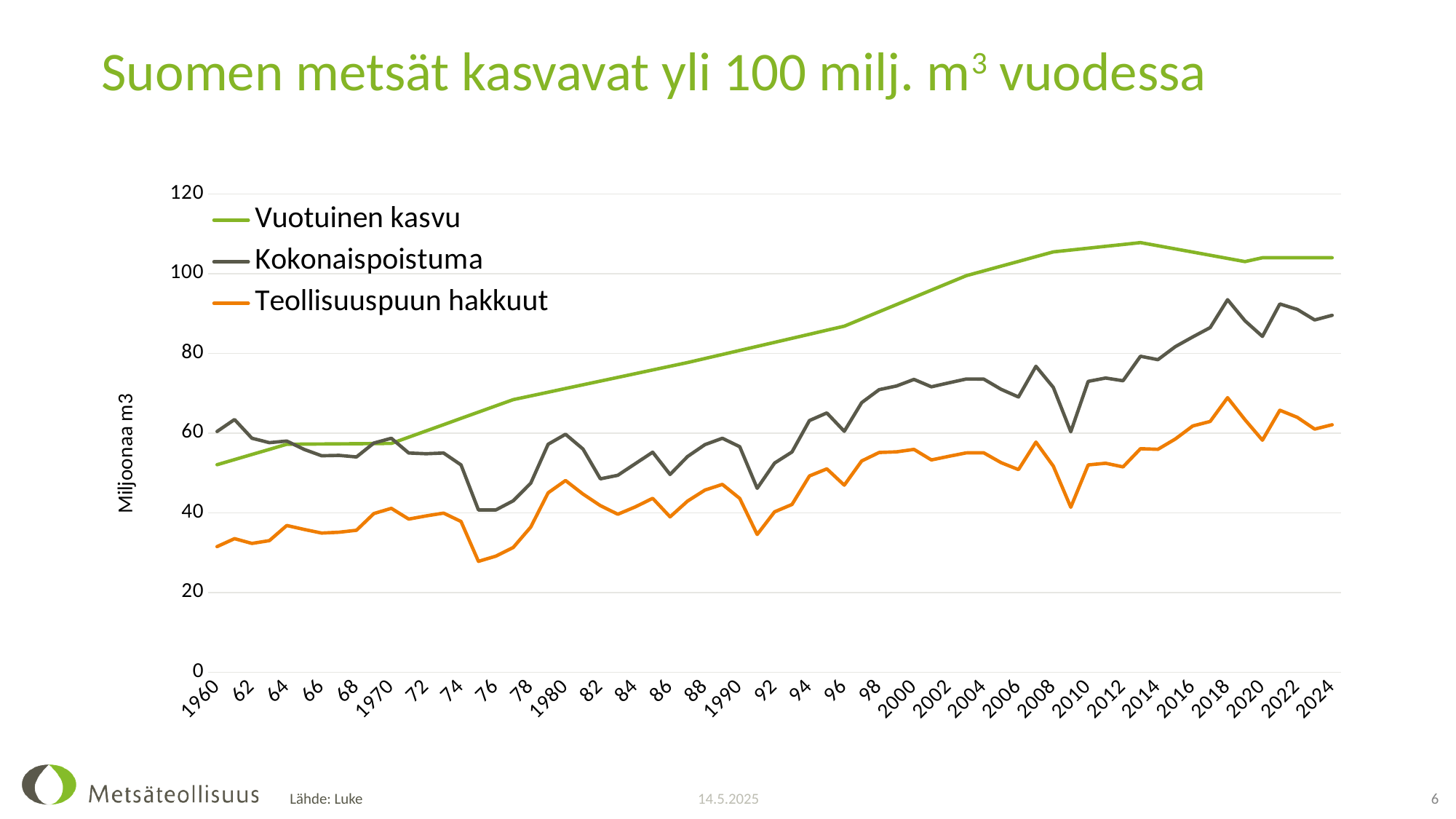
In 2024, which series has the higher value: Vuotuinen kasvu or Kokonaispoistuma? Vuotuinen kasvu How many series does the chart legend list? 3 Is the value of Teollisuuspuun hakkuut in 1976 greater or less than 40? less What is the label on the vertical axis of the chart? Miljoonaa m3 Is the value of Kokonaispoistuma in 2018 greater or less than 80? greater Is the value of Vuotuinen kasvu in 1960 greater or less than 60? less Does the Vuotuinen kasvu series generally rise or fall from 1960 to 2024? Rise In 1960, which series has the higher value: Kokonaispoistuma or Vuotuinen kasvu? Kokonaispoistuma What kind of chart is shown on the slide? Line chart What is the title of the slide? Suomen metsät kasvavat yli 100 milj. m3 vuodessa